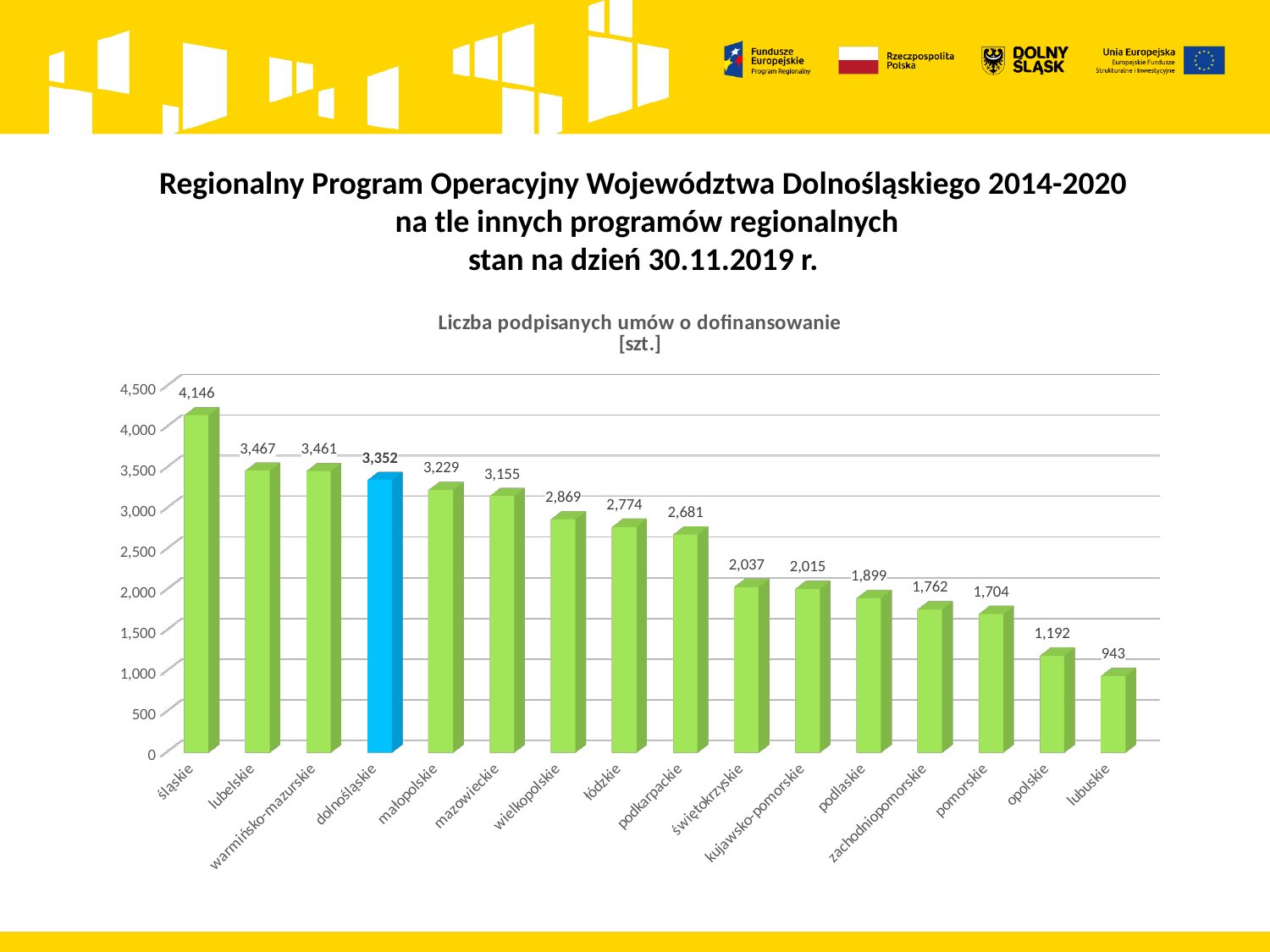
Is the value for podlaskie greater or less than 2,000? less What is the value for śląskie in the chart? 4,146 What is the value for dolnośląskie in the chart? 3,352 Which region has the lowest number of signed agreements? lubuskie Which region has the highest number of signed agreements? śląskie Which has a larger value, małopolskie or wielkopolskie? małopolskie How many regions are shown in the chart? 16 Which bar is highlighted in a different colour (blue) in the chart? dolnośląskie What is the difference between the values for opolskie and lubuskie? 249 What is the value for opolskie in the chart? 1,192 What is the difference between the values for śląskie and dolnośląskie? 794 What kind of chart is shown on the slide? bar chart